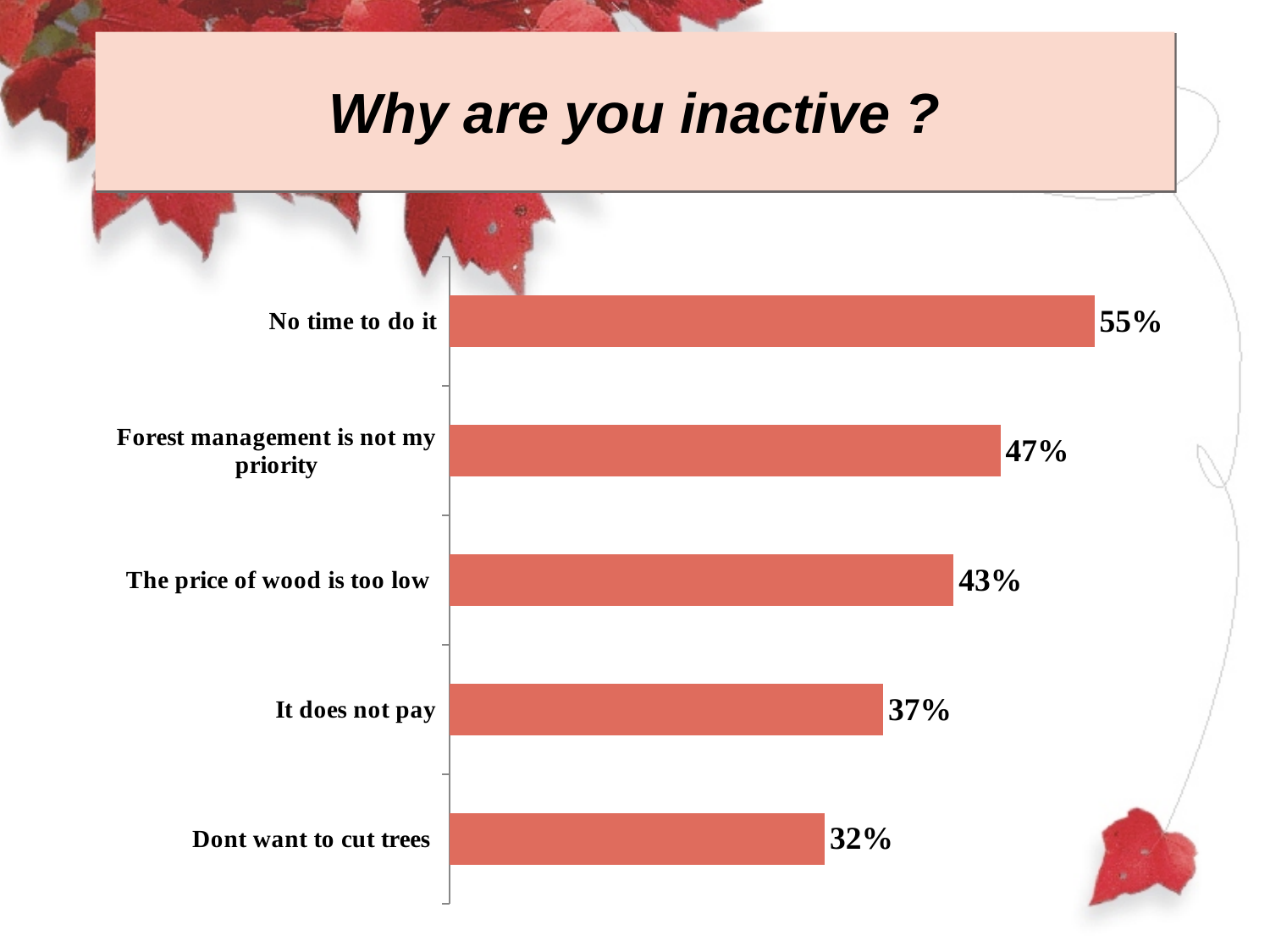
Which reason has the highest value? No time to do it How many reasons are shown in the chart? 5 What is the value for "It does not pay"? 37% What percentage of respondents said "No time to do it"? 55% What is the value for "Dont want to cut trees"? 32% What kind of chart is shown on the slide? Bar chart What is the value for "The price of wood is too low"? 43% Which reason has the lowest value? Dont want to cut trees Which is larger: "The price of wood is too low" or "It does not pay"? The price of wood is too low What is the difference between "Forest management is not my priority" and "It does not pay"? 10% What is the difference between "No time to do it" and "Dont want to cut trees"? 23% What is the value for "Forest management is not my priority"? 47%